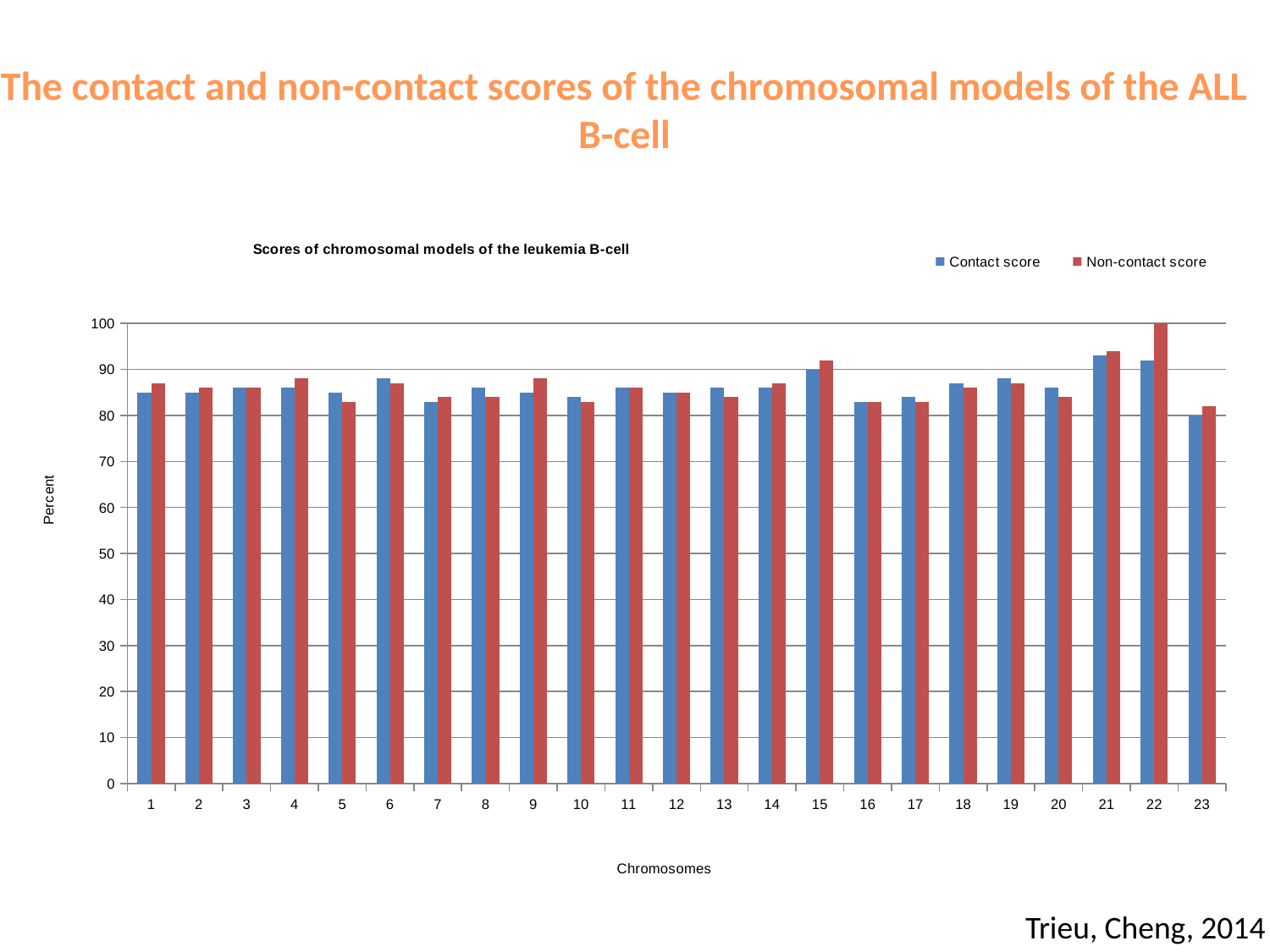
What is the label of the y axis? Percent How many chromosomes are shown on the x axis? 23 Which chromosome has the highest Non-contact score? 22 Which chromosome has the lowest Contact score? 23 For chromosome 22, which is larger, the Contact score or the Non-contact score? Non-contact score How many series does the legend list? 2 For chromosome 15, which is larger, the Contact score or the Non-contact score? Non-contact score What is the title printed above the chart area? Scores of chromosomal models of the leukemia B-cell What is the Non-contact score for chromosome 22? 100 Is the Non-contact score for chromosome 21 greater or less than 90? greater What kind of chart is shown on the slide? bar chart Is the Contact score for chromosome 7 greater or less than 90? less